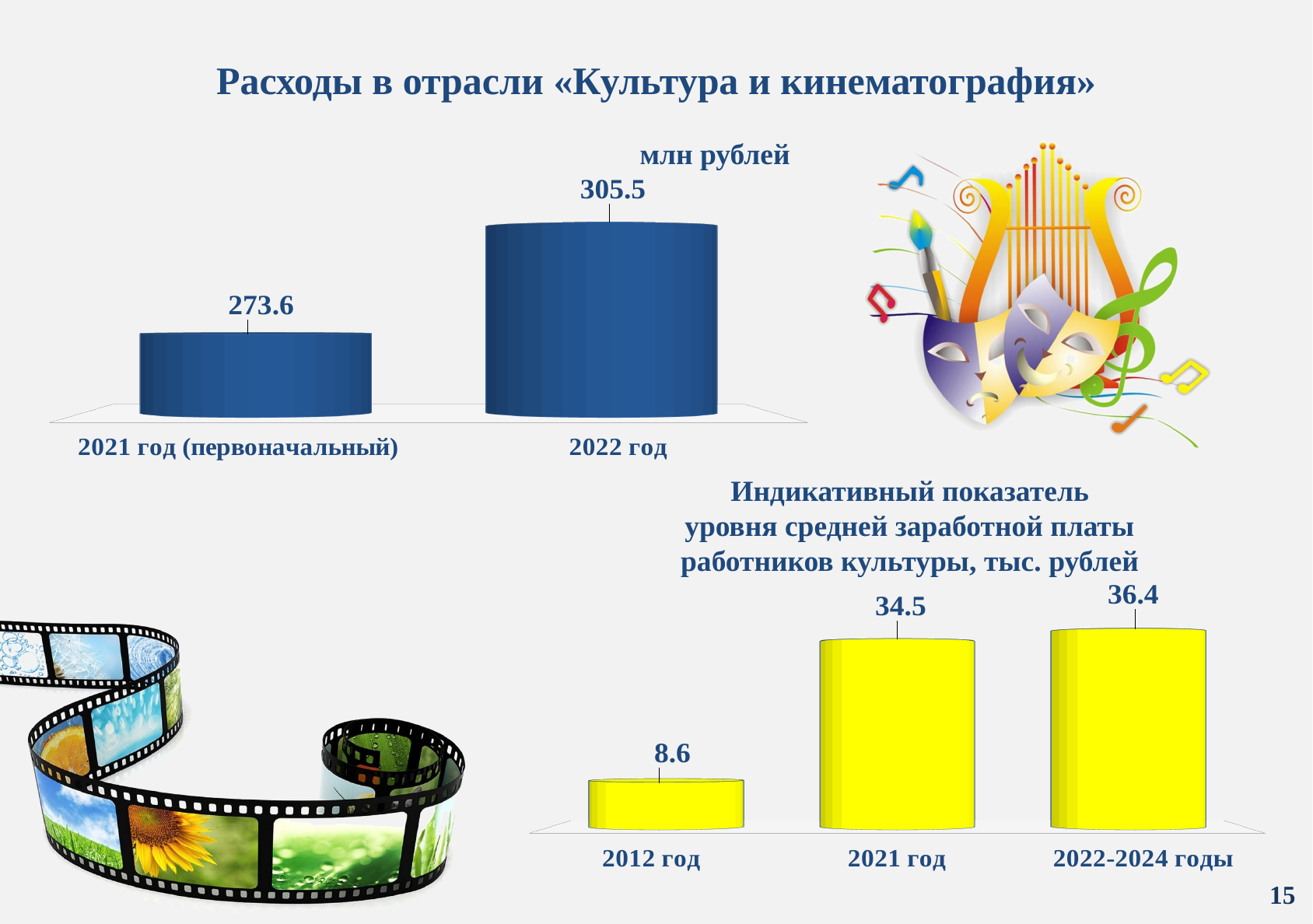
In the bottom chart of the indicative average salary of culture workers, how many categories are shown? 3 In the bottom chart of the indicative average salary of culture workers, which period has the lowest value? 2012 год In the bottom chart of the indicative average salary of culture workers, what is the value for 2022-2024 годы? 36.4 In the top chart of expenses in the 'Культура и кинематография' sector, what is the value for 2022 год? 305.5 In the bottom chart of the indicative average salary of culture workers, what is the difference between the 2022-2024 годы value and the 2021 год value? 1.9 In the top chart of expenses in the 'Культура и кинематография' sector, which year has the higher value? 2022 год In the bottom chart of the indicative average salary of culture workers, what is the value for 2012 год? 8.6 In the top chart of expenses in the 'Культура и кинематография' sector, what unit is stated for the values? млн рублей In the bottom chart of the indicative average salary of culture workers, do the values rise or fall from 2012 год to 2022-2024 годы? rise In the top chart of expenses in the 'Культура и кинематография' sector, by how much does the 2022 год value exceed the 2021 год (первоначальный) value? 31.9 In the top chart of expenses in the 'Культура и кинематография' sector, what is the value for 2021 год (первоначальный)? 273.6 What type of chart is the bottom chart of the indicative average salary of culture workers? bar chart